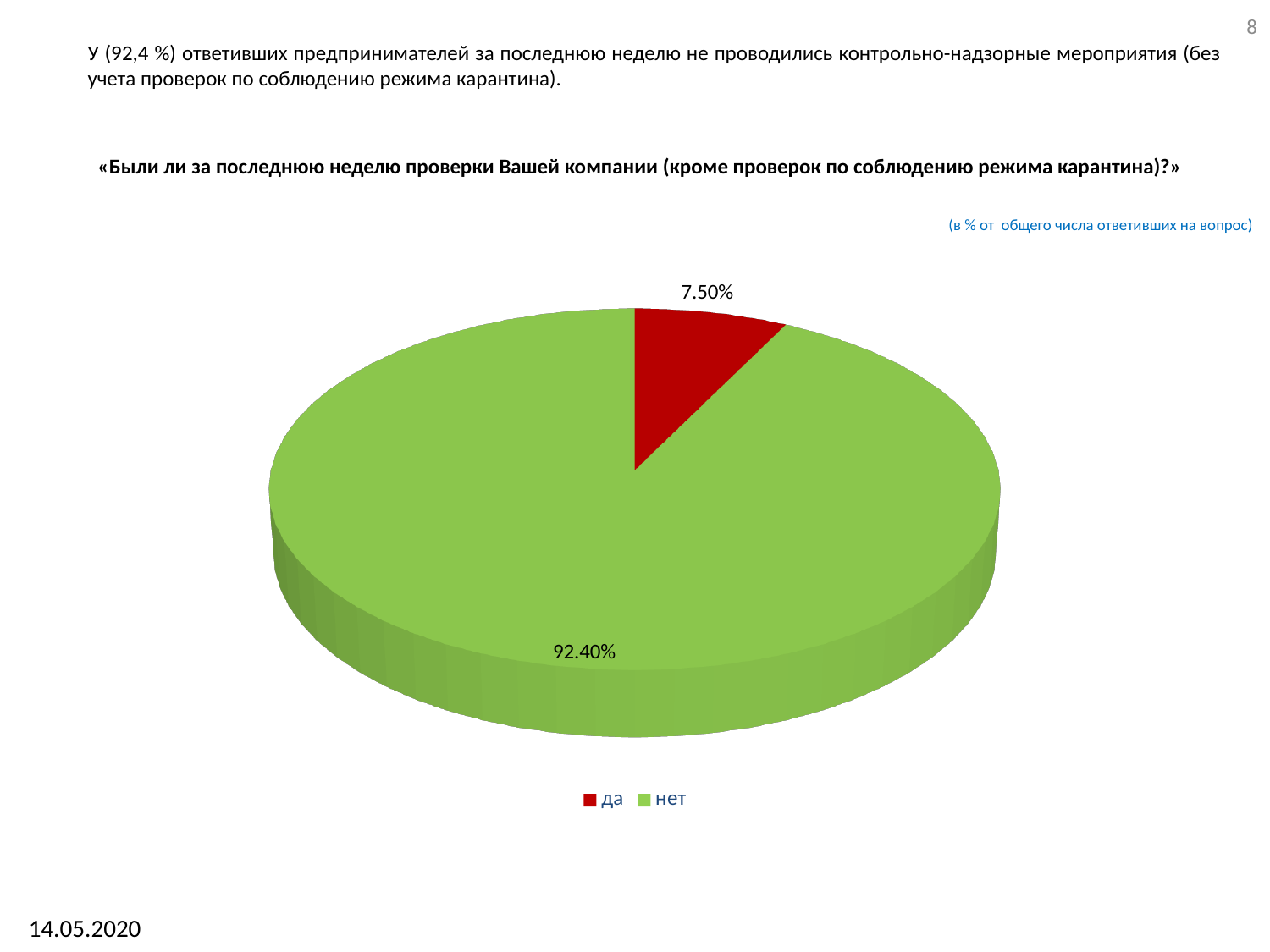
Which is larger, the share for "да" or the share for "нет"? нет How many entries does the legend list? 2 What type of chart is shown on the slide? pie chart Which category has the largest share of the pie? нет What is the difference between the share for "нет" and the share for "да"? 84.90% What is the value for "да" in the pie chart? 7.50% What colour is the slice for "нет"? green How many categories does the pie chart show? 2 What is the value for "нет" in the pie chart? 92.40% Which category has the smallest share of the pie? да What colour is the slice for "да"? red